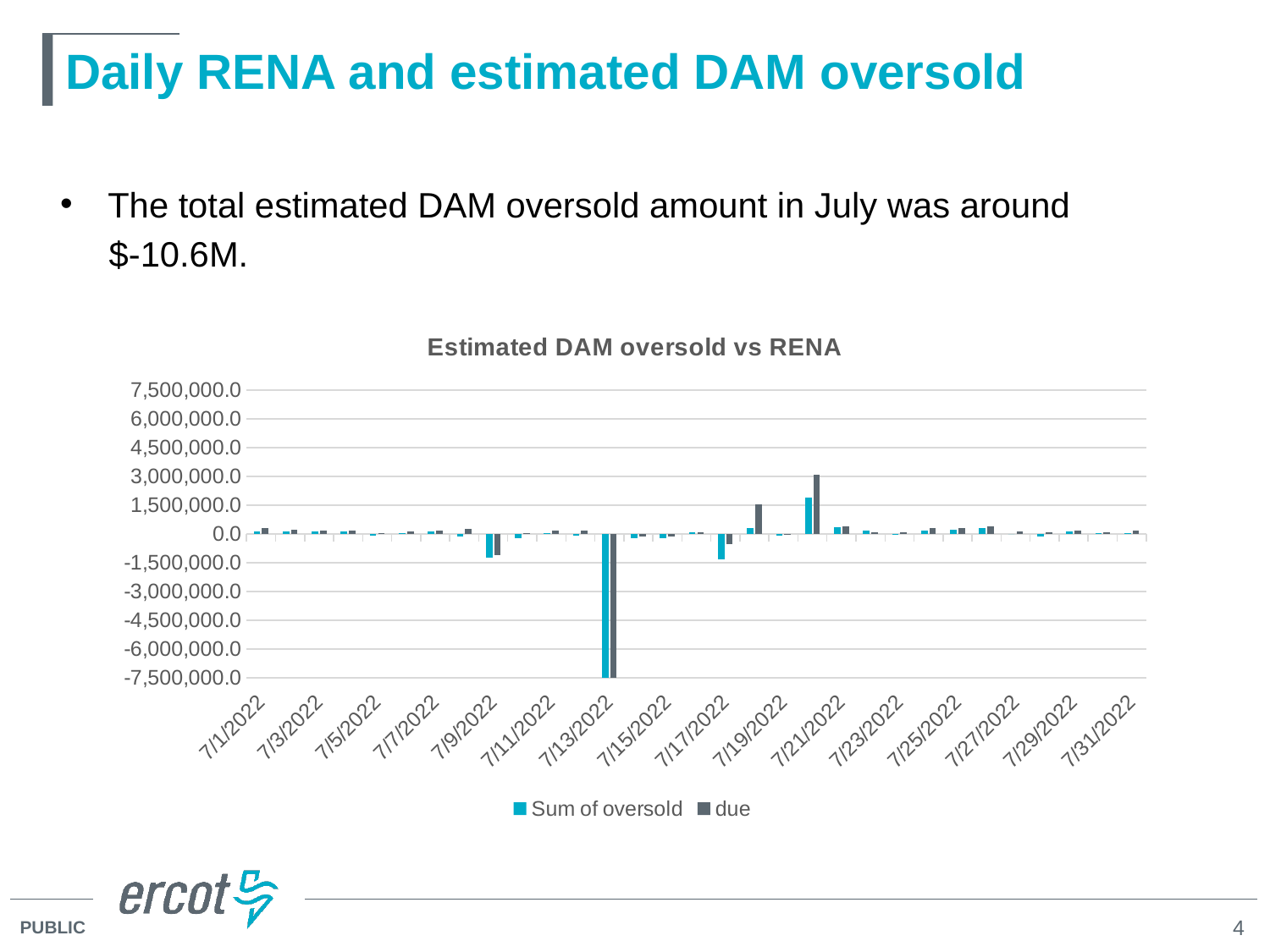
What is the last date label on the chart's x axis? 7/31/2022 Which series has the tallest positive bar on the chart, Sum of oversold or due? due Is the lowest bar on the chart greater or less than -6,000,000.0? less What type of chart is shown on the slide? Bar chart What is the title of the chart? Estimated DAM oversold vs RENA What is the lowest value shown on the chart's y axis? -7,500,000.0 What is the first date label on the chart's x axis? 7/1/2022 How many date labels are printed along the chart's x axis? 16 What are the two series named in the chart legend? Sum of oversold and due How many series does the legend of the chart list? 2 What is the highest value shown on the chart's y axis? 7,500,000.0 Is the tallest 'due' bar on the chart greater or less than 1,500,000.0? greater